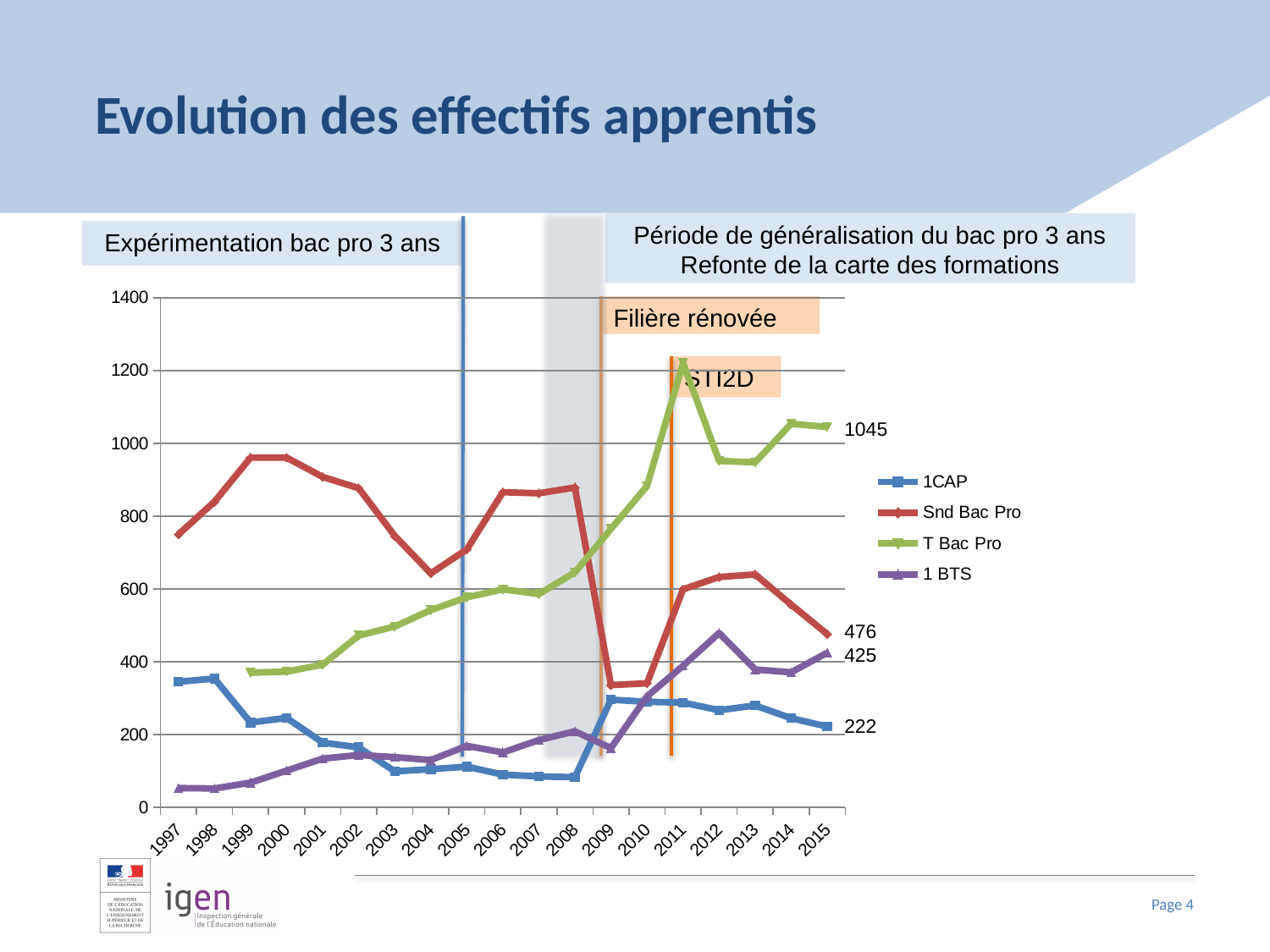
What is the difference between the 2015 values of T Bac Pro and Snd Bac Pro? 569 In 2015, which is larger: the value for Snd Bac Pro or the value for 1 BTS? Snd Bac Pro Is the value for Snd Bac Pro in 1999 greater or less than 800? greater What is the value for T Bac Pro in 2015? 1045 Which series has the highest value in 2015? T Bac Pro Which series has the lowest value in 2015? 1CAP What type of chart is shown on the slide? Line chart What is the value for Snd Bac Pro in 2015? 476 How many years are shown on the x axis of the chart? 19 What is the value for 1CAP in 2015? 222 How many series does the chart legend list? 4 Does the 1CAP series rise or fall overall from 1997 to 2008? Fall